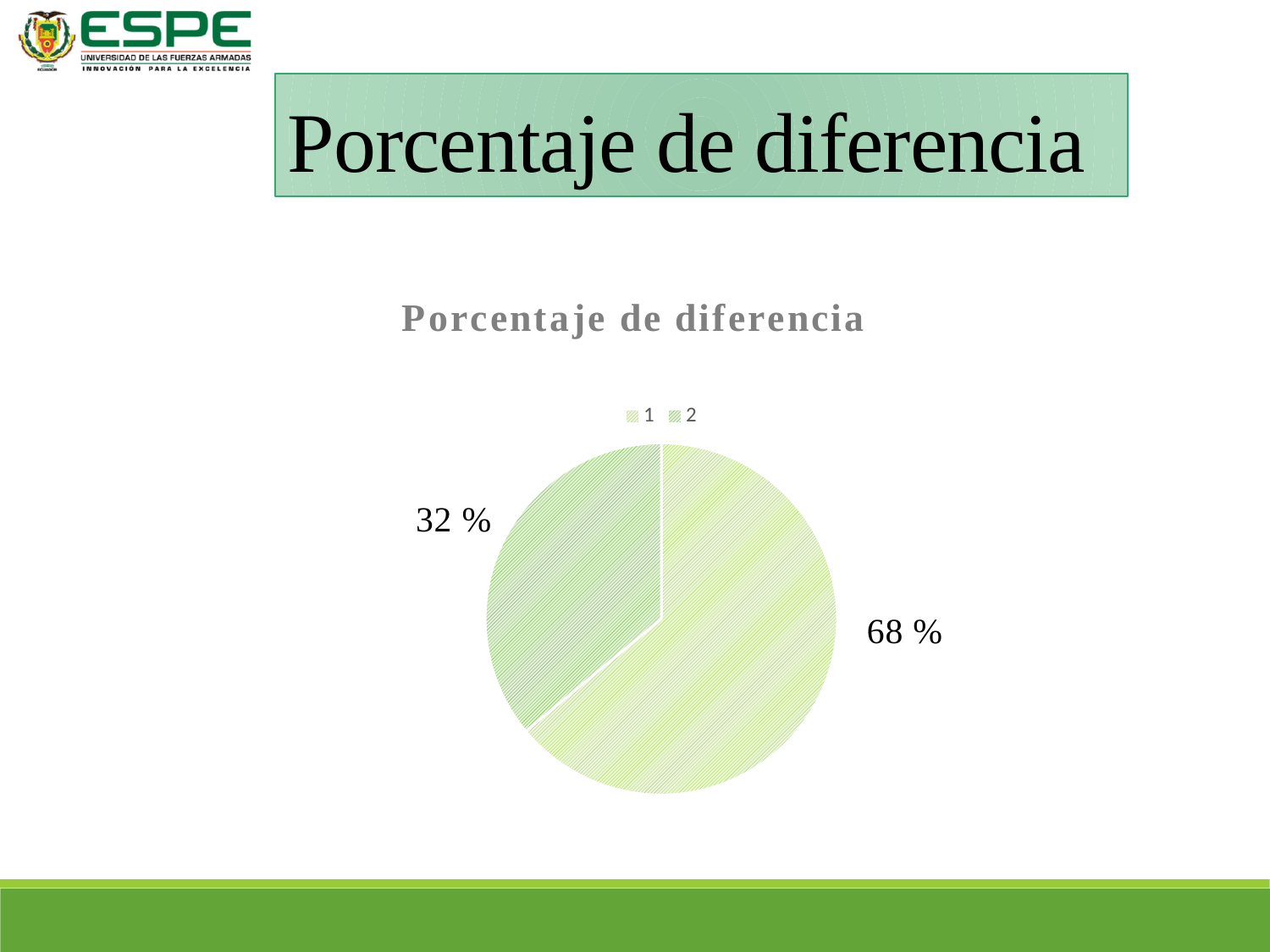
Which category has the largest slice of the pie? 1 What is the difference in percentage points between the slice for category 1 and the slice for category 2? 36 What is the title of the chart? Porcentaje de diferencia What percentage is shown for category 1? 68 % How many slices does the pie chart have? 2 How many entries does the legend list? 2 Which is larger, the slice for category 1 or the slice for category 2? 1 What kind of chart is shown on the slide? Pie chart What percentage is shown for category 2? 32 % Which category has the smallest slice of the pie? 2 What share of the pie does category 2 represent? 32 % What are the labels listed in the legend? 1 and 2